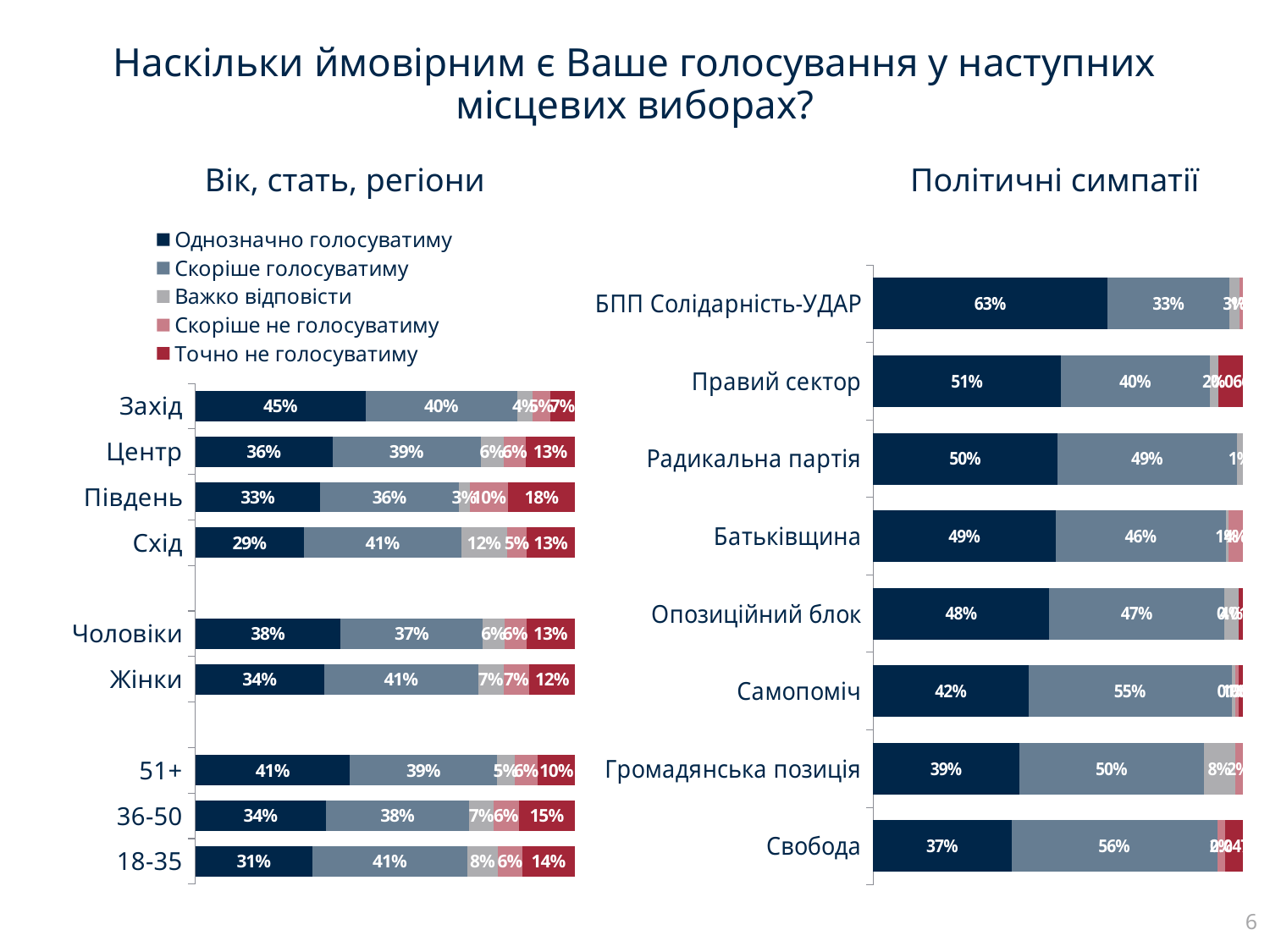
How many parties are shown in the chart 'Політичні симпатії'? 8 In the chart 'Вік, стать, регіони', what is the value of 'Точно не голосуватиму' for Південь? 18% In the chart 'Вік, стать, регіони', which is larger: the 'Точно не голосуватиму' value for 36-50 or for 51+? 36-50 In the chart 'Вік, стать, регіони', which region has the lowest value for 'Однозначно голосуватиму'? Схід In the chart 'Вік, стать, регіони', what is the value of 'Важко відповісти' for Схід? 12% In the chart 'Політичні симпатії', which party has the highest value for 'Однозначно голосуватиму'? БПП Солідарність-УДАР In the chart 'Політичні симпатії', what is the value of 'Скоріше голосуватиму' for Самопоміч? 55% How many series does the legend of the chart 'Вік, стать, регіони' list? 5 In the chart 'Політичні симпатії', which party has the lowest value for 'Однозначно голосуватиму'? Свобода In the chart 'Вік, стать, регіони', what is the value of 'Однозначно голосуватиму' for Захід? 45% In the chart 'Політичні симпатії', what is the value of 'Однозначно голосуватиму' for БПП Солідарність-УДАР? 63% In the chart 'Вік, стать, регіони', what is the difference between the 'Однозначно голосуватиму' values for Чоловіки and Жінки? 4%